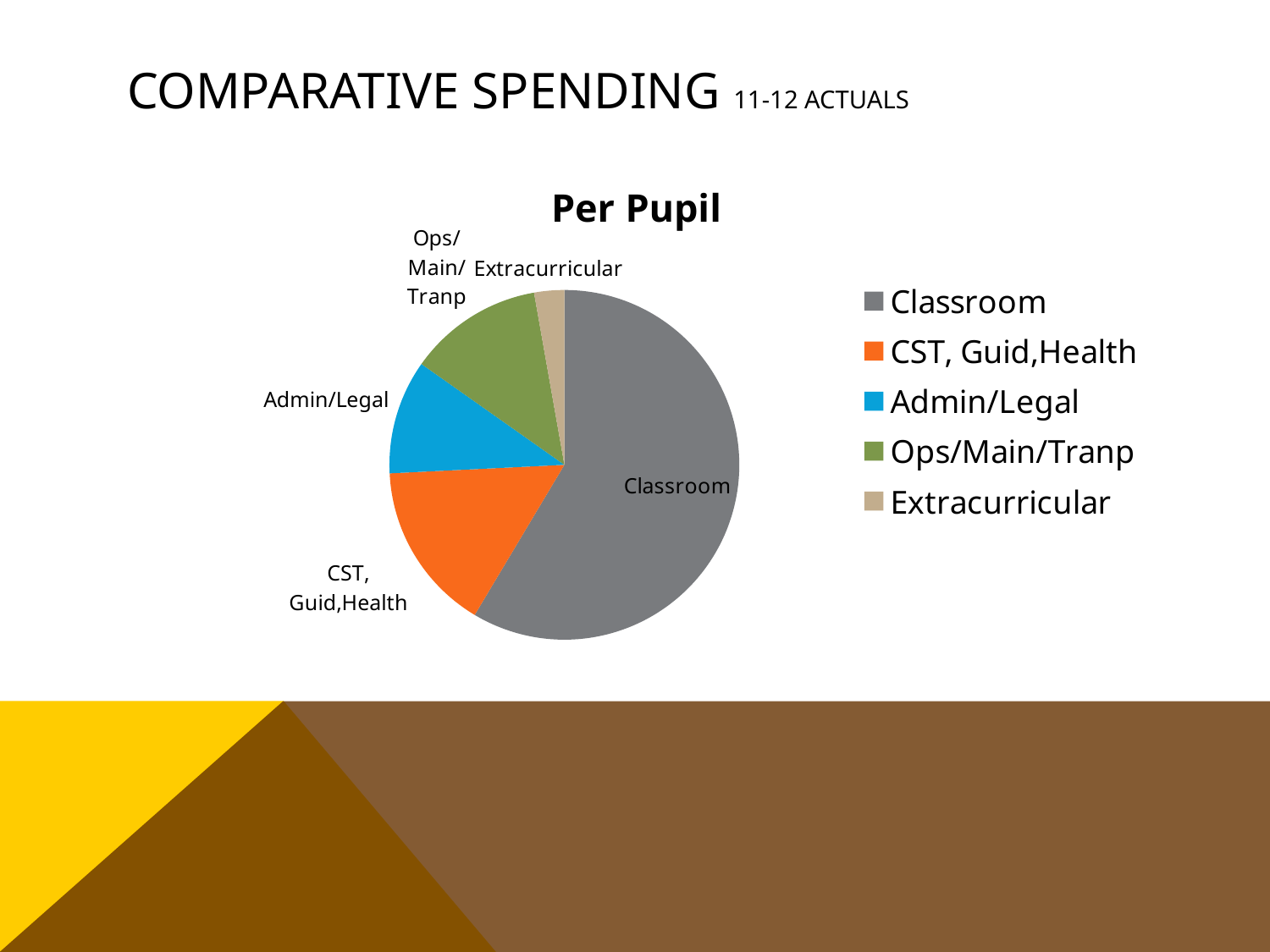
Which slice is larger, Ops/Main/Tranp or Extracurricular? Ops/Main/Tranp Which category has the largest slice of the pie? Classroom Which slice is larger, CST, Guid,Health or Admin/Legal? CST, Guid,Health What kind of chart is shown on the slide? Pie chart What is the title of the chart? Per Pupil Which slice is larger, Classroom or CST, Guid,Health? Classroom Which category has the smallest slice of the pie? Extracurricular How many entries does the legend list? 5 What colour is the Classroom slice in the pie chart? Gray How many slices does the pie chart have? 5